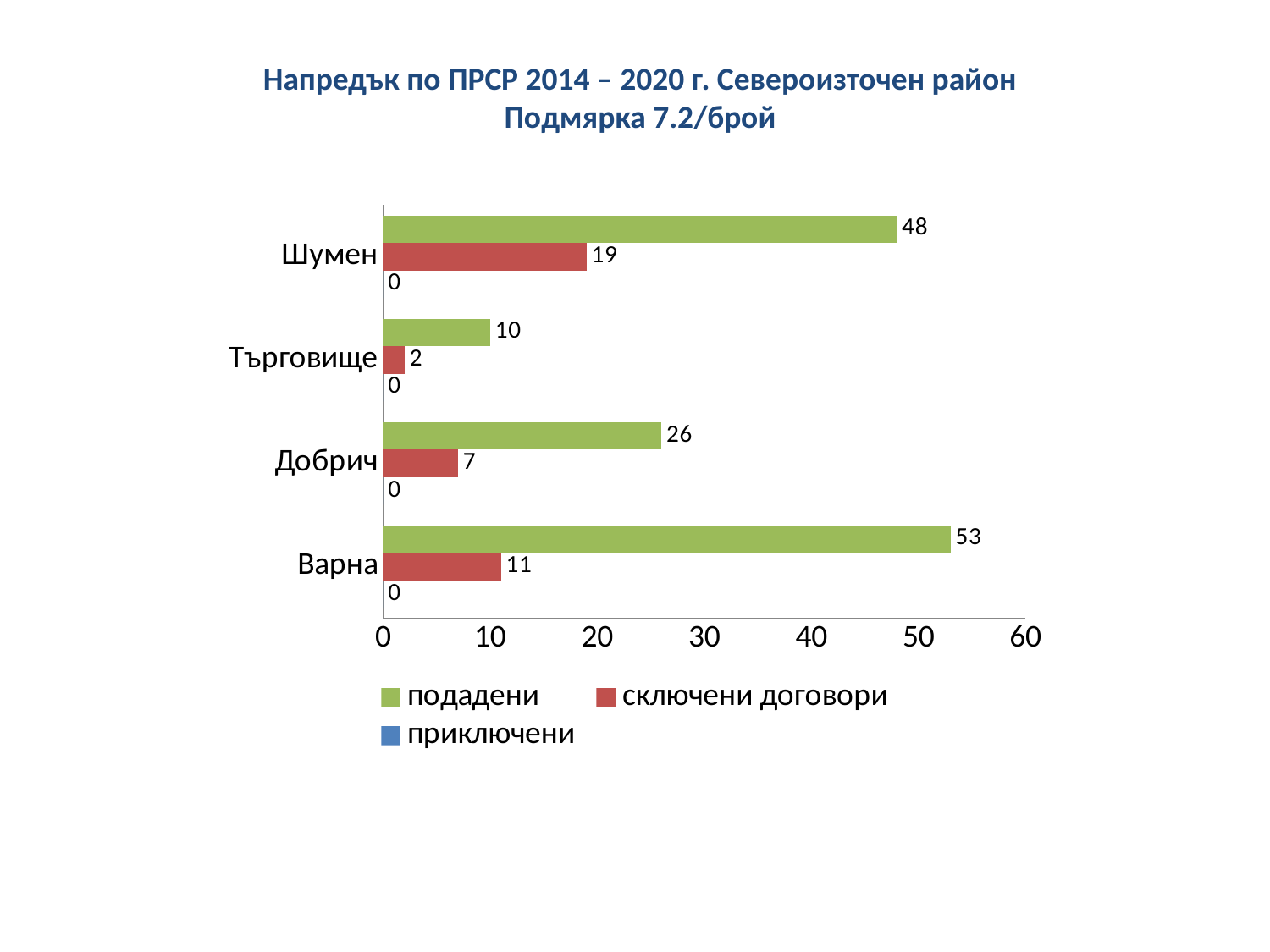
Which category has the highest value for подадени? Варна What is the title of the chart? Напредък по ПРСР 2014 – 2020 г. Североизточен район Подмярка 7.2/брой What is the value of подадени for Варна? 53 What is the value of сключени договори for Шумен? 19 What is the difference between подадени and сключени договори for Шумен? 29 What is the value of приключени for Добрич? 0 How many series does the legend list? 3 What is the value of подадени for Търговище? 10 How many categories are shown on the chart? 4 Which category has the lowest value for сключени договори? Търговище Which is larger: подадени for Добрич or подадени for Търговище? Добрич What kind of chart is shown on the slide? Bar chart